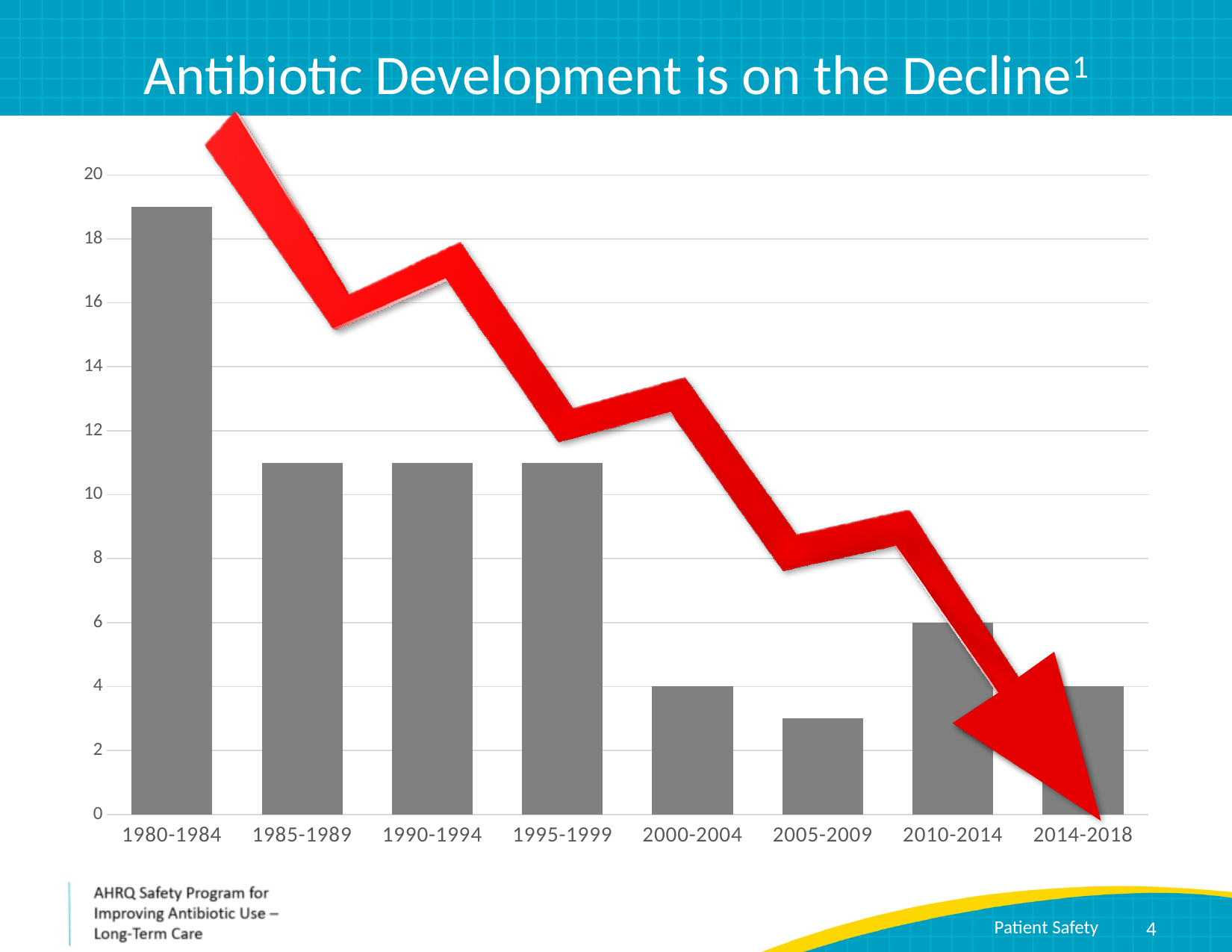
Is the value for 1980-1984 greater or less than 18? greater Overall, do the values rise or fall from 1980-1984 to 2014-2018? fall Is the value for 2005-2009 greater or less than 4? less What is the difference between the values for 2010-2014 and 2014-2018? 2 Which period has the highest bar? 1980-1984 Which is larger, the value for 1980-1984 or the value for 1985-1989? 1980-1984 How many time-period categories are shown on the x axis? 8 What kind of chart is shown on the slide? bar chart What is the value for 2000-2004? 4 What is the value for 2014-2018? 4 What is the value for 2010-2014? 6 Which period has the lowest bar? 2005-2009